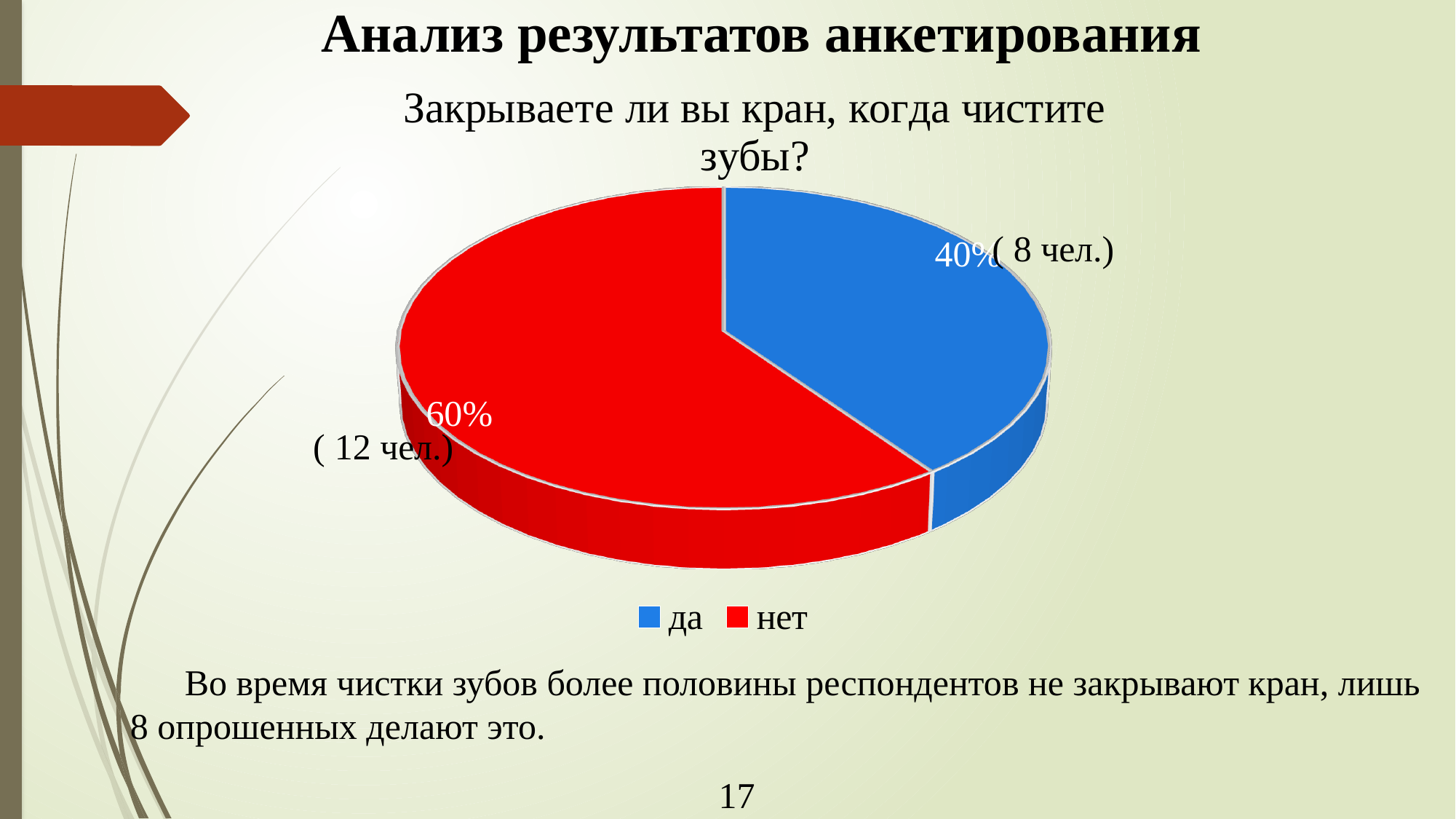
Which answer has the largest share of the pie? нет What percentage of respondents answered "нет"? 60% How many categories does the legend list? 2 How many people answered "нет"? 12 чел. How many people answered "да"? 8 чел. What type of chart is shown on the slide? pie chart Which is larger, the share for "да" or the share for "нет"? нет Which answer has the smallest share of the pie? да What colour represents "нет" in the chart? red What is the difference in percentage points between "нет" and "да"? 20% What is the chart's title? Закрываете ли вы кран, когда чистите зубы? What percentage of respondents answered "да"? 40%